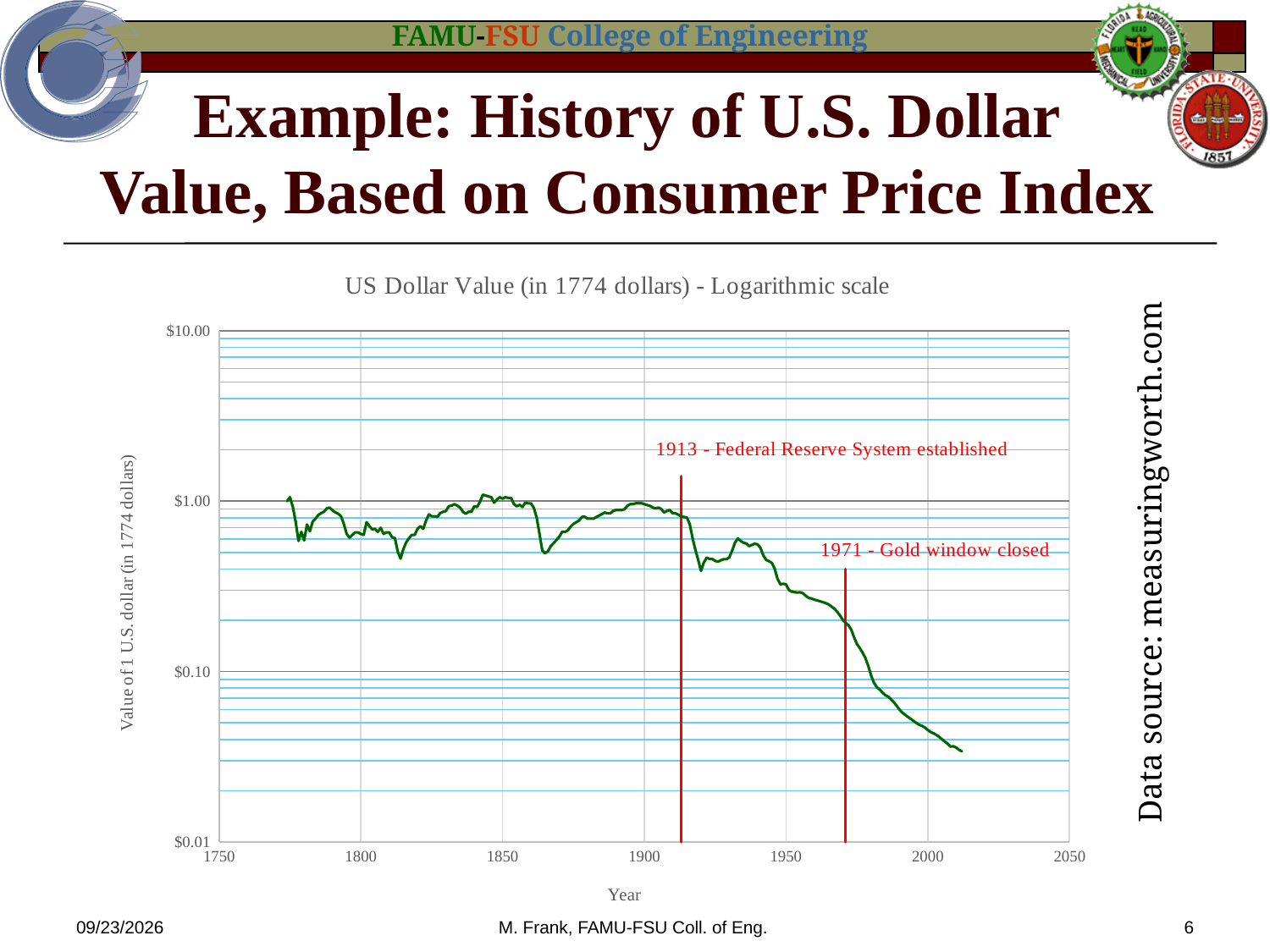
Is the value of the U.S. dollar in the year 1950 greater or less than $1.00? less What is the label of the x axis of the chart? Year What kind of chart is shown on the slide? line chart Which is larger on the chart: the dollar value in 1950 or the dollar value in 1980? 1950 Is the value of the U.S. dollar in the year 1800 greater or less than $0.10? greater Is the value of the U.S. dollar in the year 2000 greater or less than $0.10? less What event does the chart mark with a vertical line at 1913? Federal Reserve System established What is the title of the chart? US Dollar Value (in 1774 dollars) - Logarithmic scale Does the value of the U.S. dollar rise or fall between 1913 and 2010 on the chart? fall Which is larger on the chart: the dollar value in 1900 or the dollar value in 2000? 1900